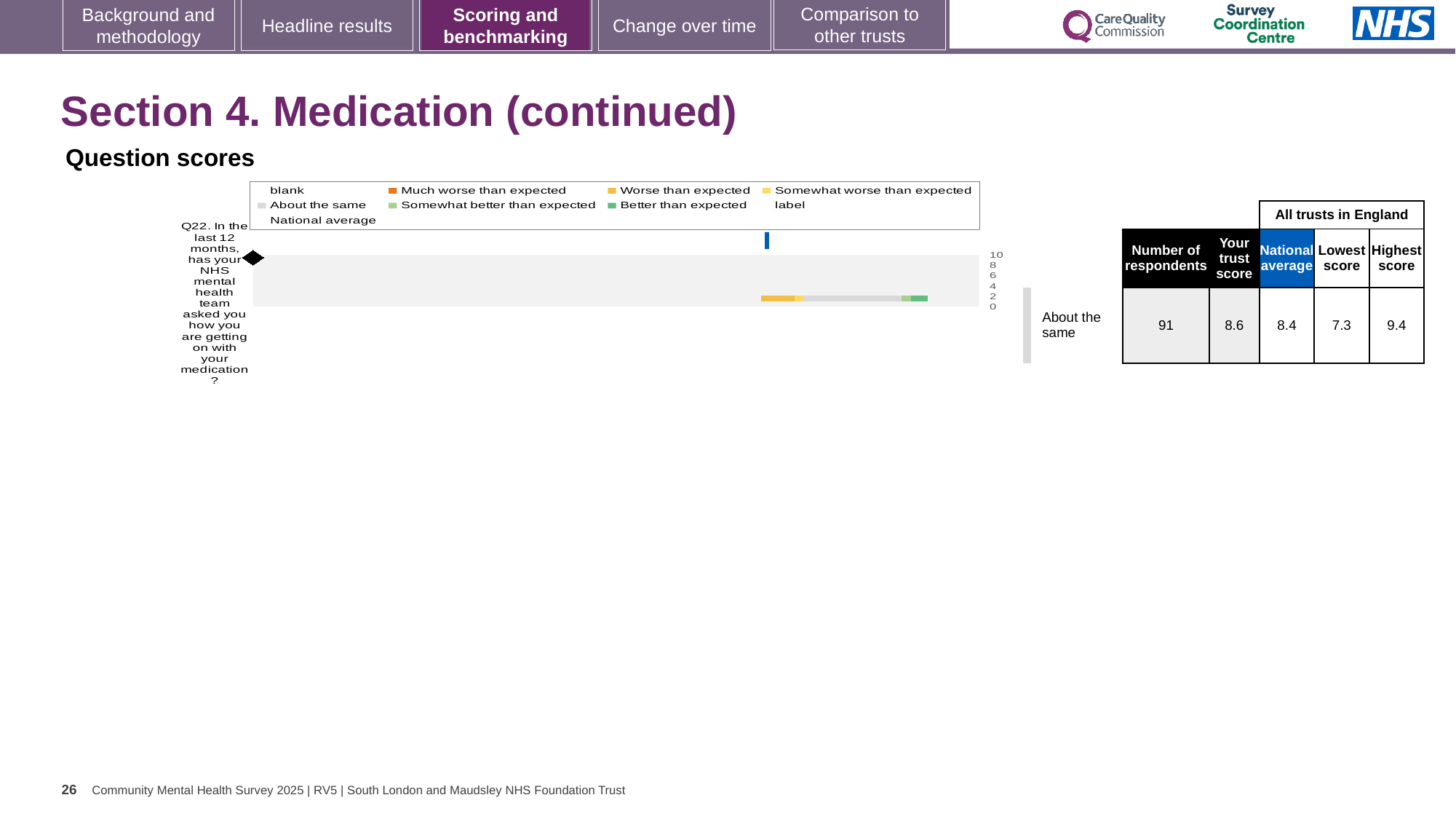
What is the difference between the highest and lowest trust scores for Q22? 2.1 What is the trust's score for Q22 (asked how you are getting on with your medication)? 8.6 What is the national average score shown for Q22? 8.4 Which is larger for Q22: the trust's score or the national average? Your trust score (8.6) By how much does the trust's score for Q22 exceed the national average? 0.2 How many survey questions are plotted in the Question scores chart? 1 Is the trust's score for Q22 greater or less than 8? greater Which benchmarking category is the trust's Q22 score placed in? About the same What kind of chart is used to show the Q22 question score? Bar chart How many respondents answered Q22? 91 What is the lowest score among all trusts in England for Q22? 7.3 What is the highest score among all trusts in England for Q22? 9.4